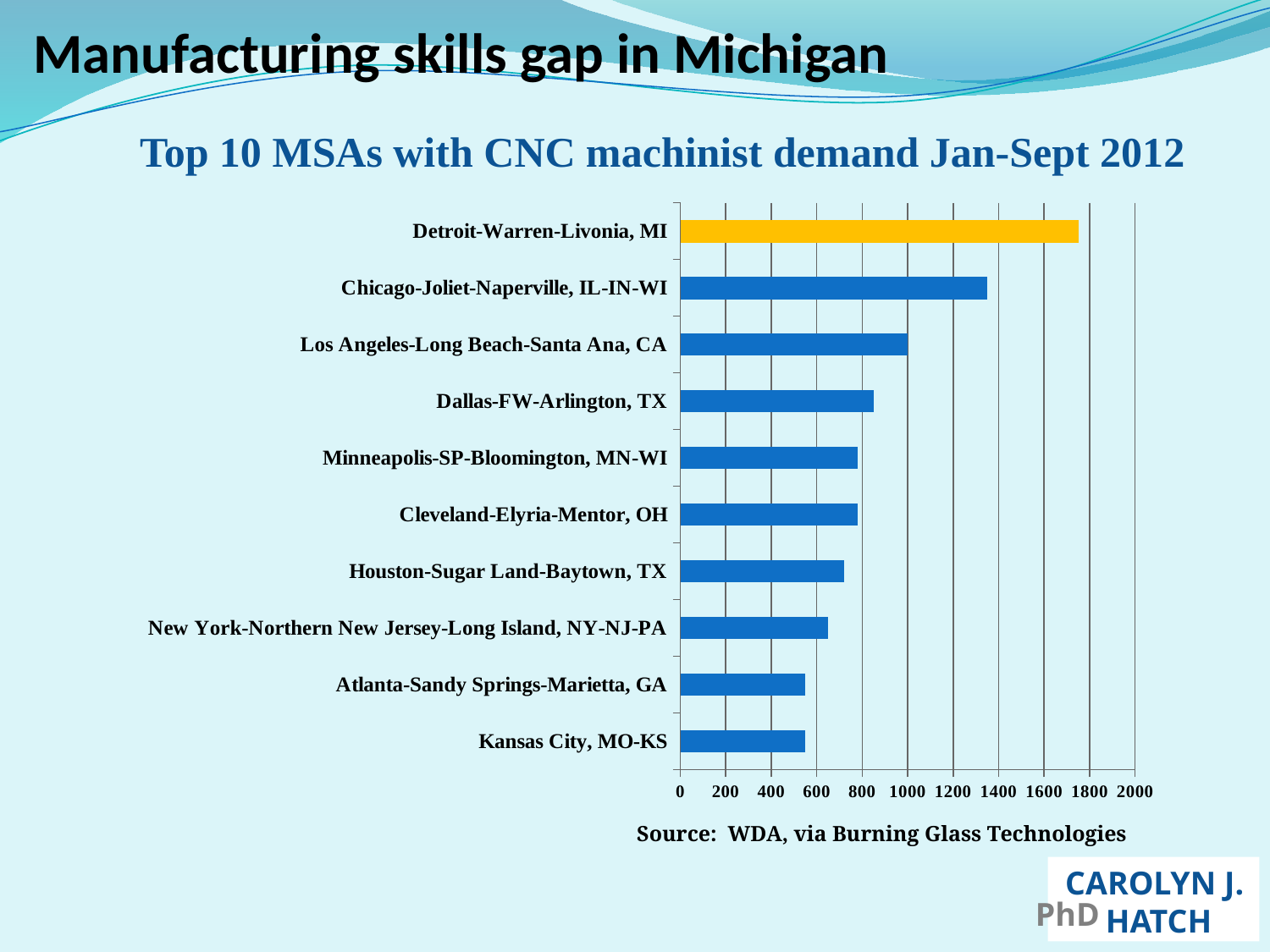
Which MSA has the highest CNC machinist demand in the chart? Detroit-Warren-Livonia, MI How many MSAs are plotted in the chart? 10 Is the value for Kansas City, MO-KS greater or less than 600? less Is the value for Chicago-Joliet-Naperville, IL-IN-WI greater or less than 1200? greater Which MSA's bar is coloured differently (yellow) from the other bars? Detroit-Warren-Livonia, MI What is the title of the chart? Top 10 MSAs with CNC machinist demand Jan-Sept 2012 Is the value for Houston-Sugar Land-Baytown, TX greater or less than 800? less What kind of chart is shown on the slide? bar chart Which has the larger value, Chicago-Joliet-Naperville, IL-IN-WI or Los Angeles-Long Beach-Santa Ana, CA? Chicago-Joliet-Naperville, IL-IN-WI Which has the larger value, Dallas-FW-Arlington, TX or Houston-Sugar Land-Baytown, TX? Dallas-FW-Arlington, TX